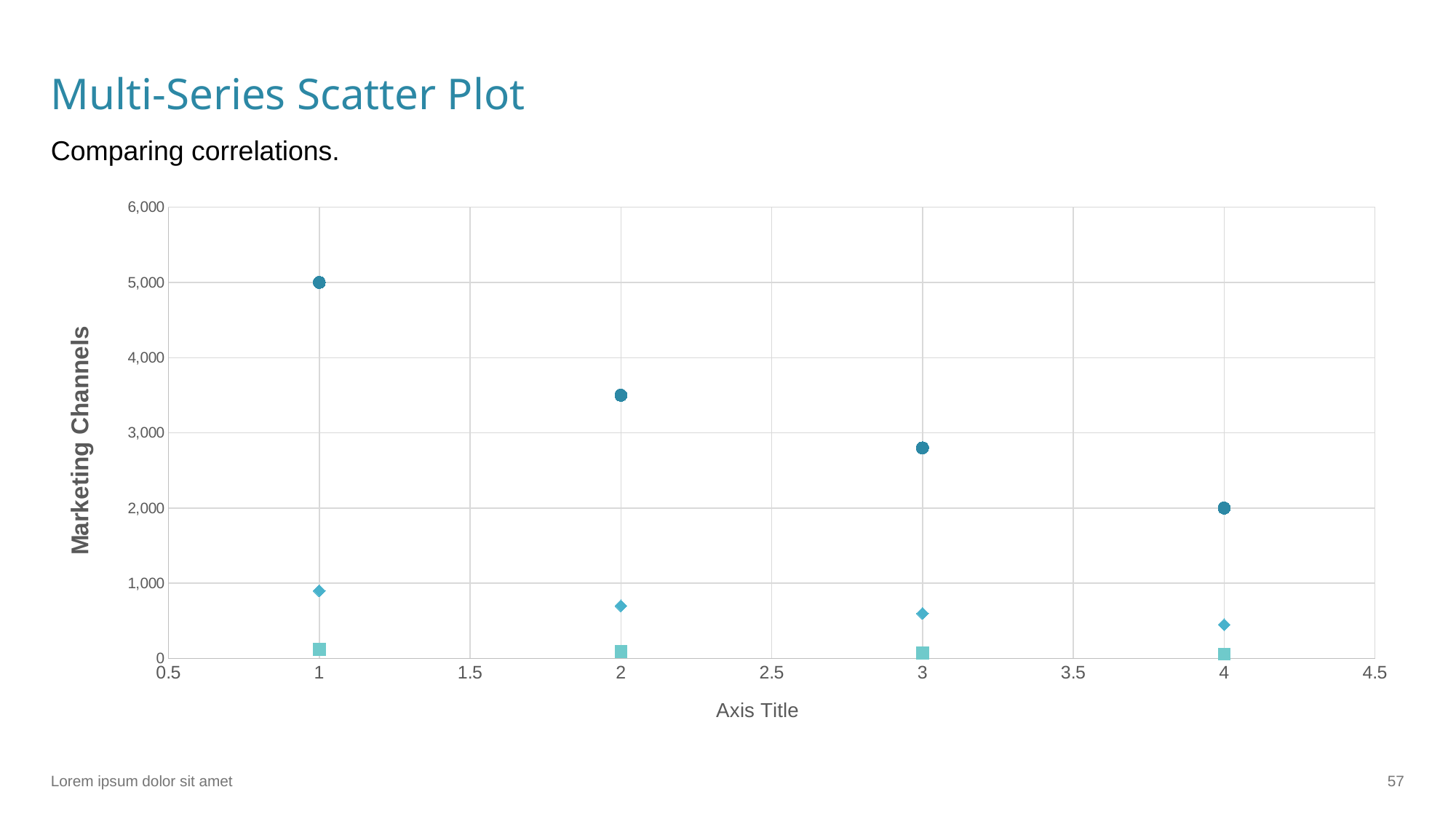
Do the y-values of the circle-marker series rise or fall as x increases? Fall What is the y-value of the circle-marker series at x = 1? 5,000 What is the difference between the circle-marker series' y-values at x = 1 and x = 4? 3,000 Is the y-value of the circle-marker series at x = 2 greater or less than 3,000? greater How many data points does each series have? 4 At which x-value does the circle-marker series reach its highest y-value? 1 Is the y-value of the circle-marker series at x = 3 greater or less than 3,000? less What is the title of the vertical axis? Marketing Channels Is the y-value of the diamond-marker series at x = 1 greater or less than 1,000? less What kind of chart is shown on the slide? Scatter plot What is the y-value of the circle-marker series at x = 4? 2,000 Which has the larger y-value: the circle-marker point at x = 2 or the circle-marker point at x = 3? x = 2